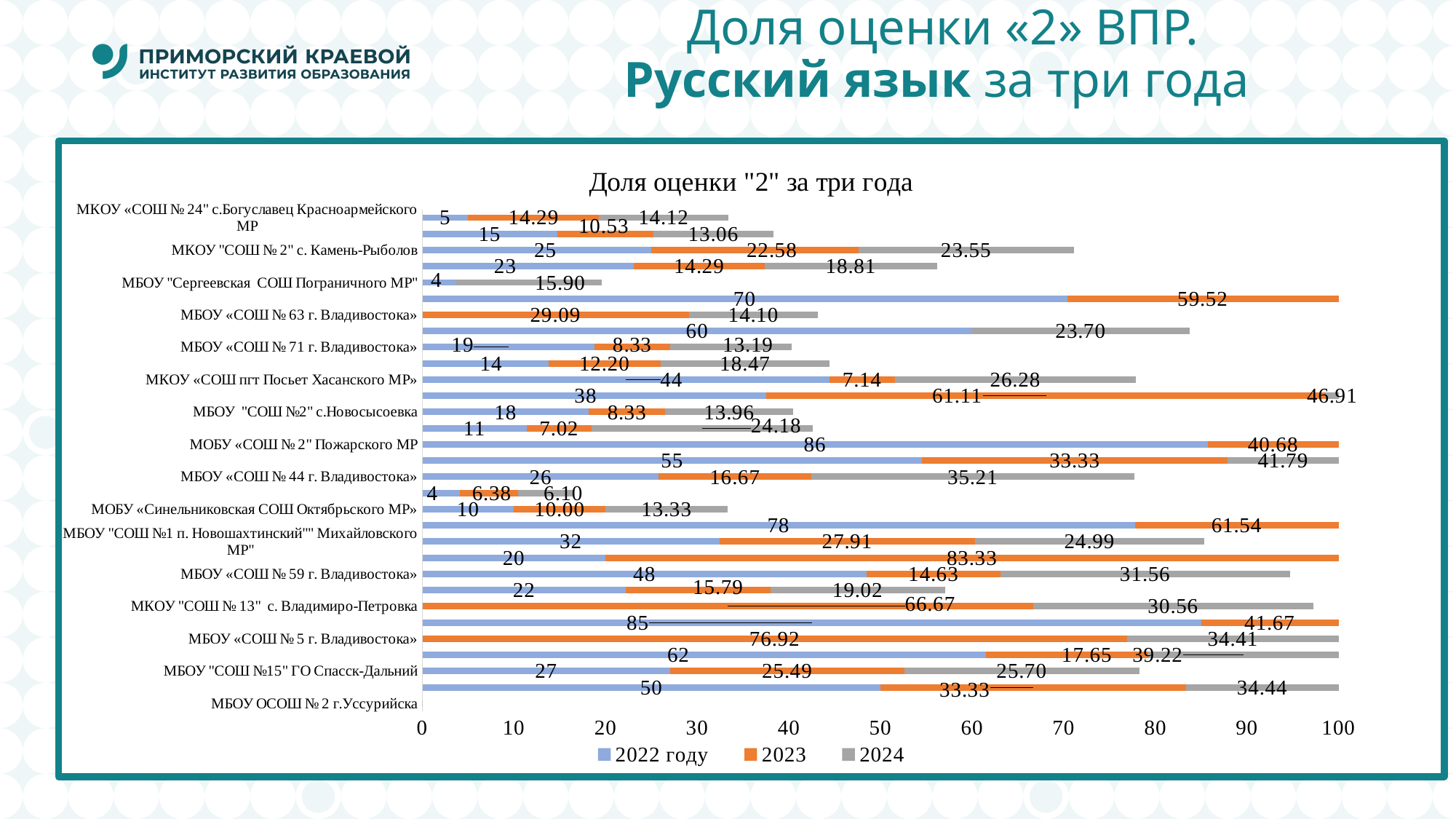
What is the 2024 value for МКОУ «СОШ № 24" с.Богуславец Красноармейского МР? 14.12 What is the title of the chart? Доля оценки "2" за три года What is the highest 2022 value printed on the chart? 86 What kind of chart is shown on the slide? bar chart How many series does the legend list? 3 What is the 2023 value for МКОУ «СОШ № 24" с.Богуславец Красноармейского МР? 14.29 What are the legend entries of the chart? 2022 году, 2023, 2024 For МКОУ «СОШ № 24" с.Богуславец Красноармейского МР, what is the difference between the 2023 value and the 2022 value? 9.29 What is the highest 2024 value printed on the chart? 46.91 What is the 2022 value for МКОУ «СОШ № 24" с.Богуславец Красноармейского МР? 5 What is the lowest 2023 value printed on the chart? 6.38 What is the highest 2023 value printed on the chart? 83.33